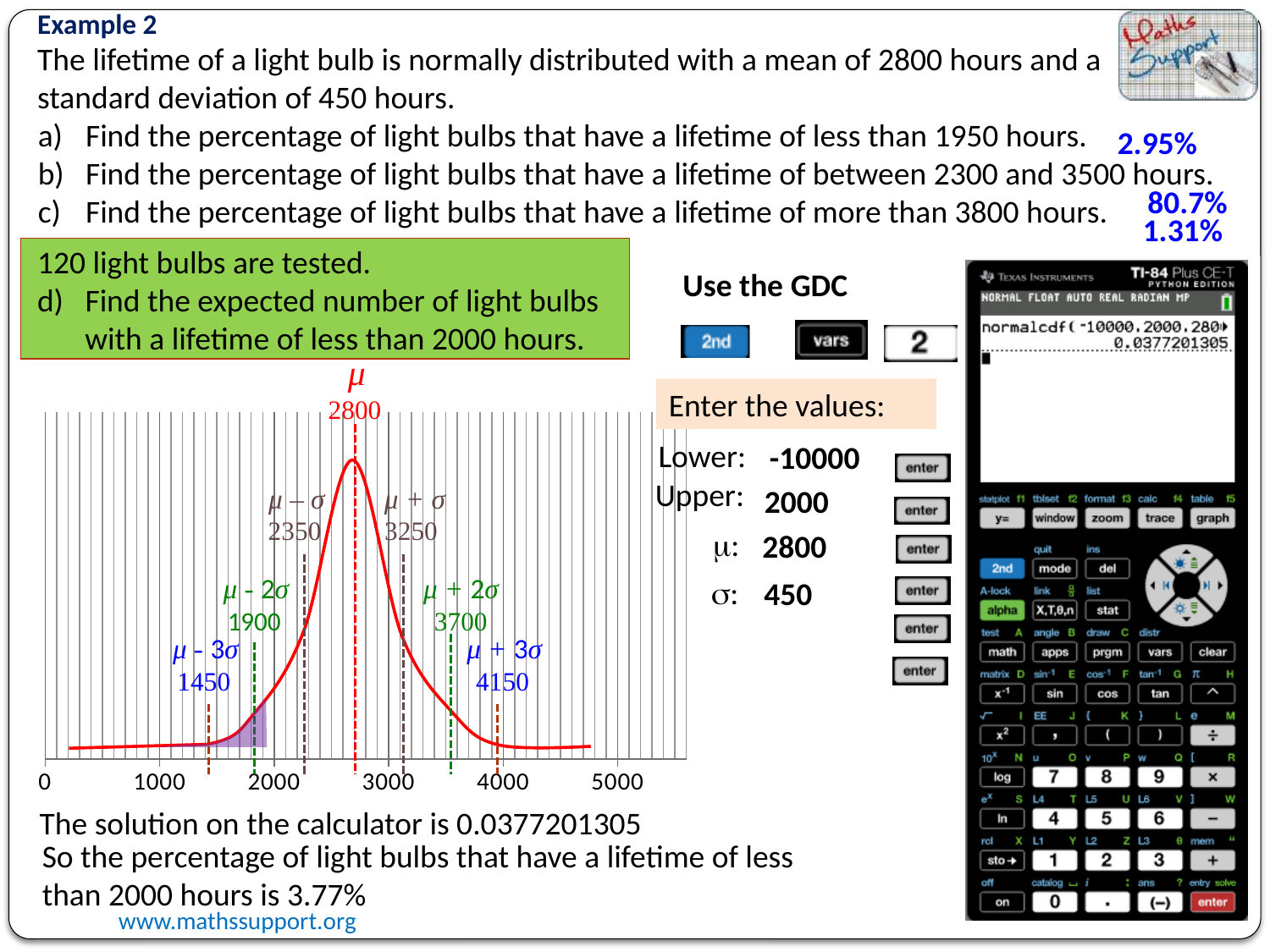
Is the value labelled at μ − 2σ greater or less than 2000? less What value is labelled at μ + σ on the curve? 3250 Which of the labelled positions on the curve has the largest value, μ + 3σ or μ + 2σ? μ + 3σ What value is labelled at the mean (μ) on the normal distribution curve? 2800 What is the difference between the values labelled at μ + σ and μ − σ on the curve? 900 What value is labelled at μ − 2σ on the curve? 1900 What value is labelled at μ + 2σ on the curve? 3700 What value is labelled at μ − σ on the curve? 2350 What colour is the normal distribution curve drawn in? Red What value is labelled at μ + 3σ on the curve? 4150 What value is labelled at μ − 3σ on the curve? 1450 What is the highest tick value shown on the x axis of the curve? 5000